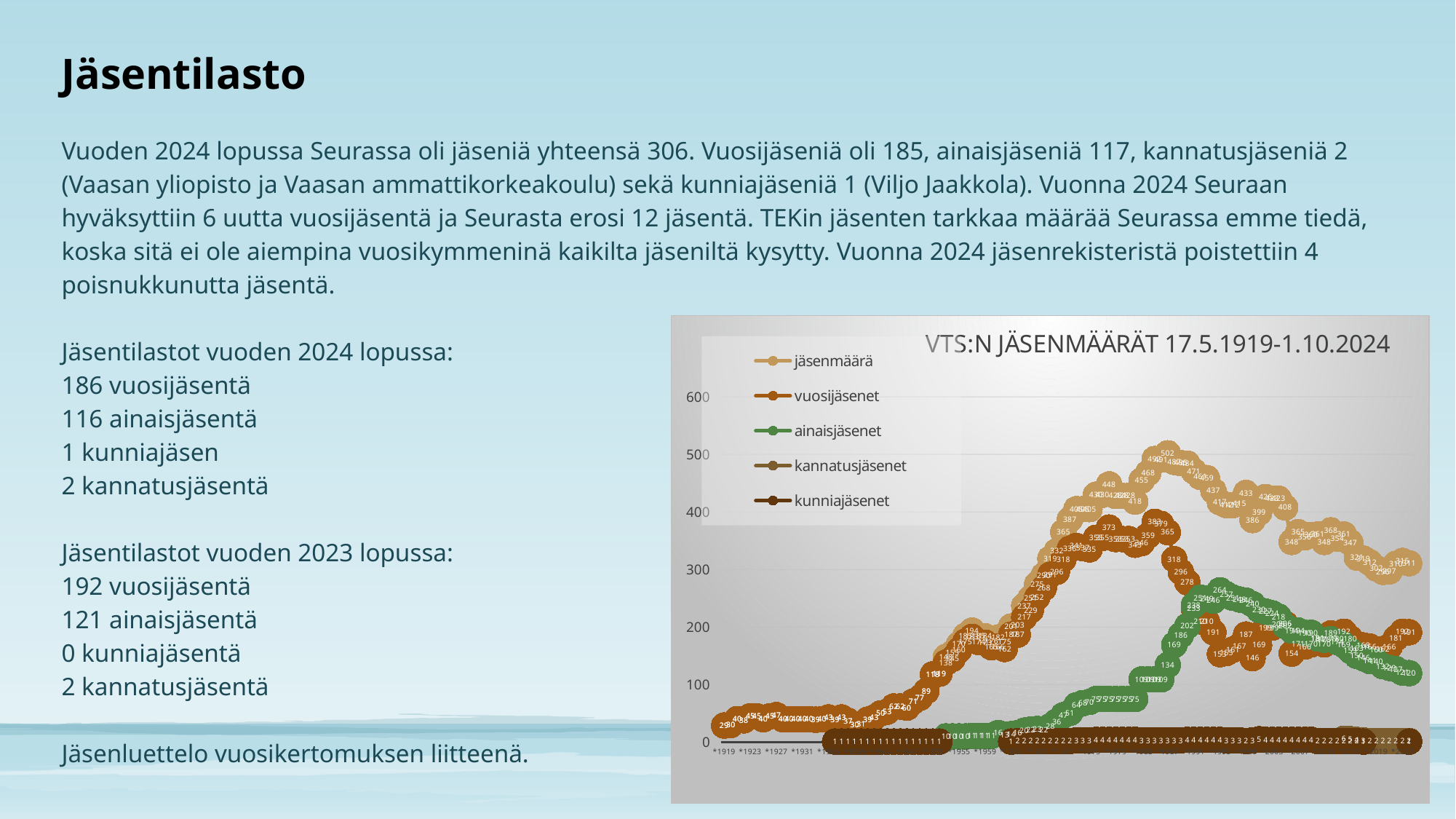
What kind of chart is shown on the slide? line chart Does the jäsenmäärä series rise or fall from the start of the chart to its peak? rise At the right end of the chart, which is higher: vuosijäsenet or ainaisjäsenet? vuosijäsenet What is the peak value of the jäsenmäärä series? 502 Is the highest value of the ainaisjäsenet series greater or less than 300? less What is the title of the chart? VTS:N JÄSENMÄÄRÄT 17.5.1919-1.10.2024 Is the highest value of the vuosijäsenet series greater or less than 300? greater Which series is listed first in the chart legend? jäsenmäärä How many series does the chart legend list? 5 Which series reaches the highest value in the chart? jäsenmäärä Is the highest value of the kannatusjäsenet series greater or less than 100? less What is the highest value shown on the vertical axis? 600